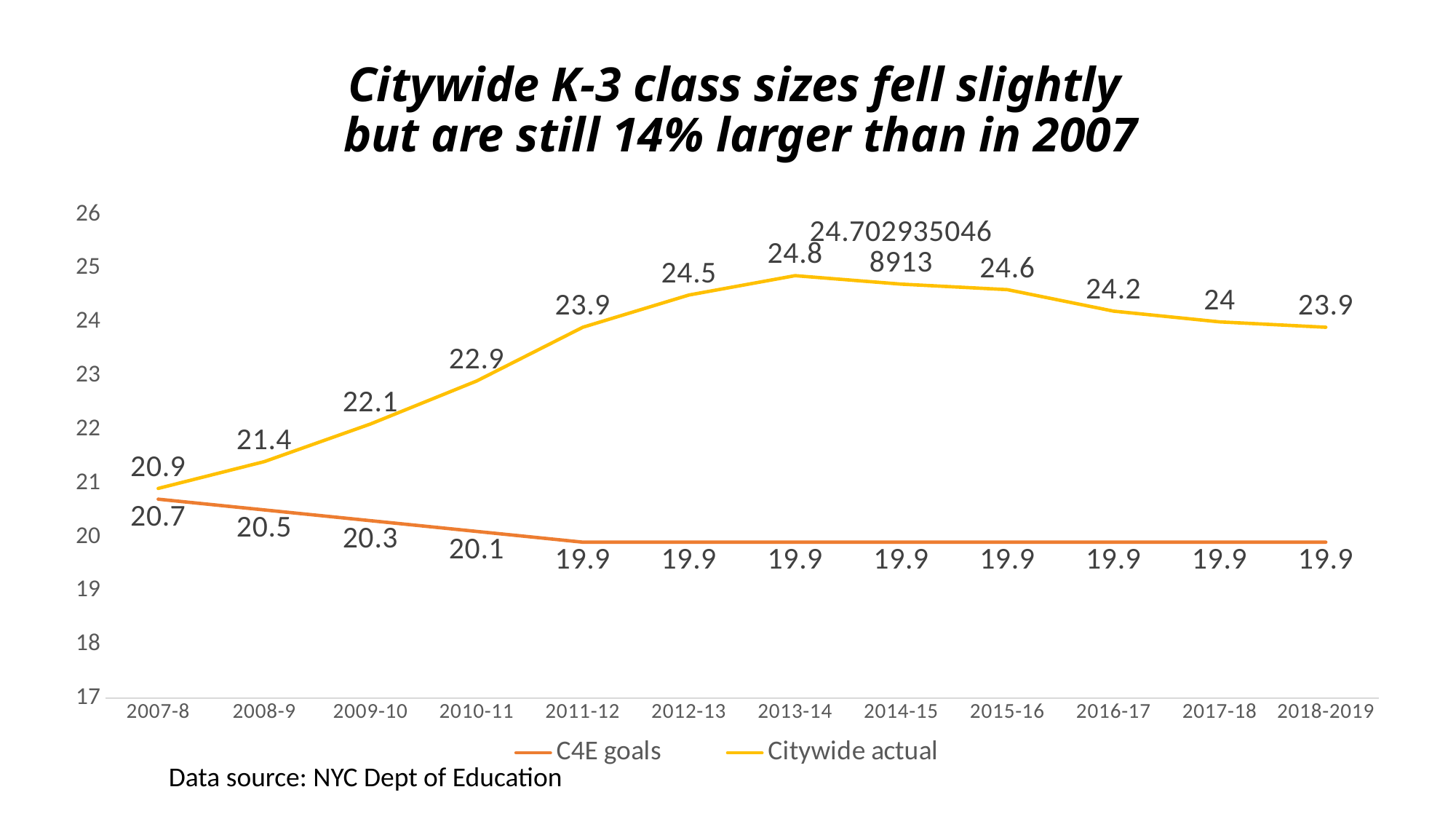
Which is larger in 2011-12, the Citywide actual value or the C4E goals value? Citywide actual What is the difference between the Citywide actual and C4E goals values in 2018-2019? 4 What is the difference between the Citywide actual and C4E goals values in 2007-8? 0.2 In which school year is the Citywide actual value highest? 2013-14 What is the Citywide actual value for 2013-14? 24.8 What is the C4E goals value for 2009-10? 20.3 Between 2007-8 and 2013-14, does the Citywide actual line rise or fall? rise In which school year is the Citywide actual value lowest? 2007-8 What kind of chart is shown on the slide? line chart How many series does the legend list? 2 How many school years are shown on the x axis? 12 What is the Citywide actual value for 2018-2019? 23.9